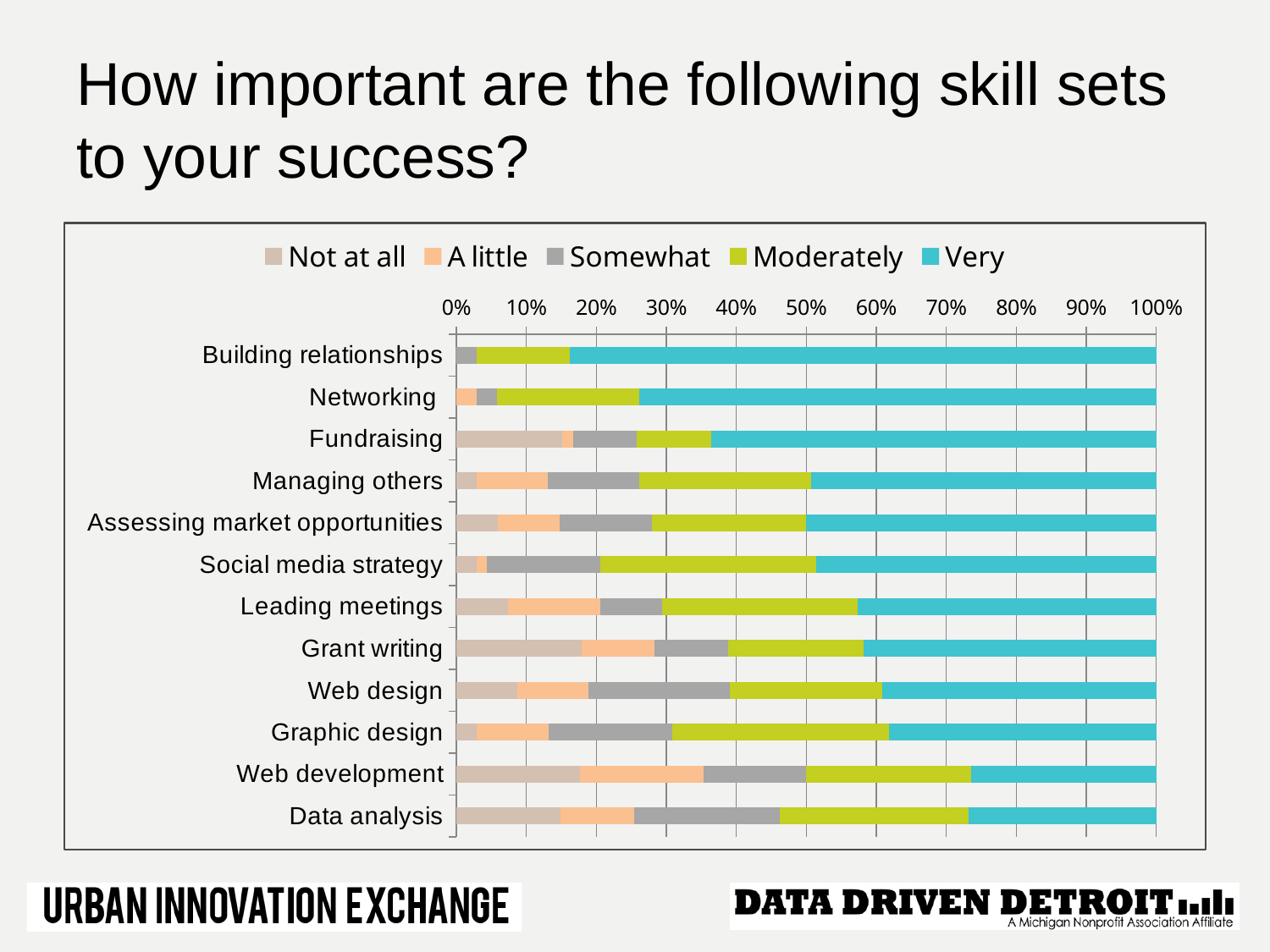
Which has the larger 'Very' share, Building relationships or Web development? Building relationships Is the 'Very' share for Building relationships greater or less than 80%? greater Is the 'Very' share for Data analysis greater or less than 30%? less What is the title of the slide containing the chart? How important are the following skill sets to your success? Is the 'Very' share for Fundraising greater or less than 60%? greater Which has the larger 'Very' share, Networking or Fundraising? Networking What is the first entry in the chart's legend? Not at all What kind of chart is shown on the slide? Stacked bar chart How many skill sets (categories) are listed on the chart? 12 Which skill set has the largest 'Very' share? Building relationships How many series does the legend list? 5